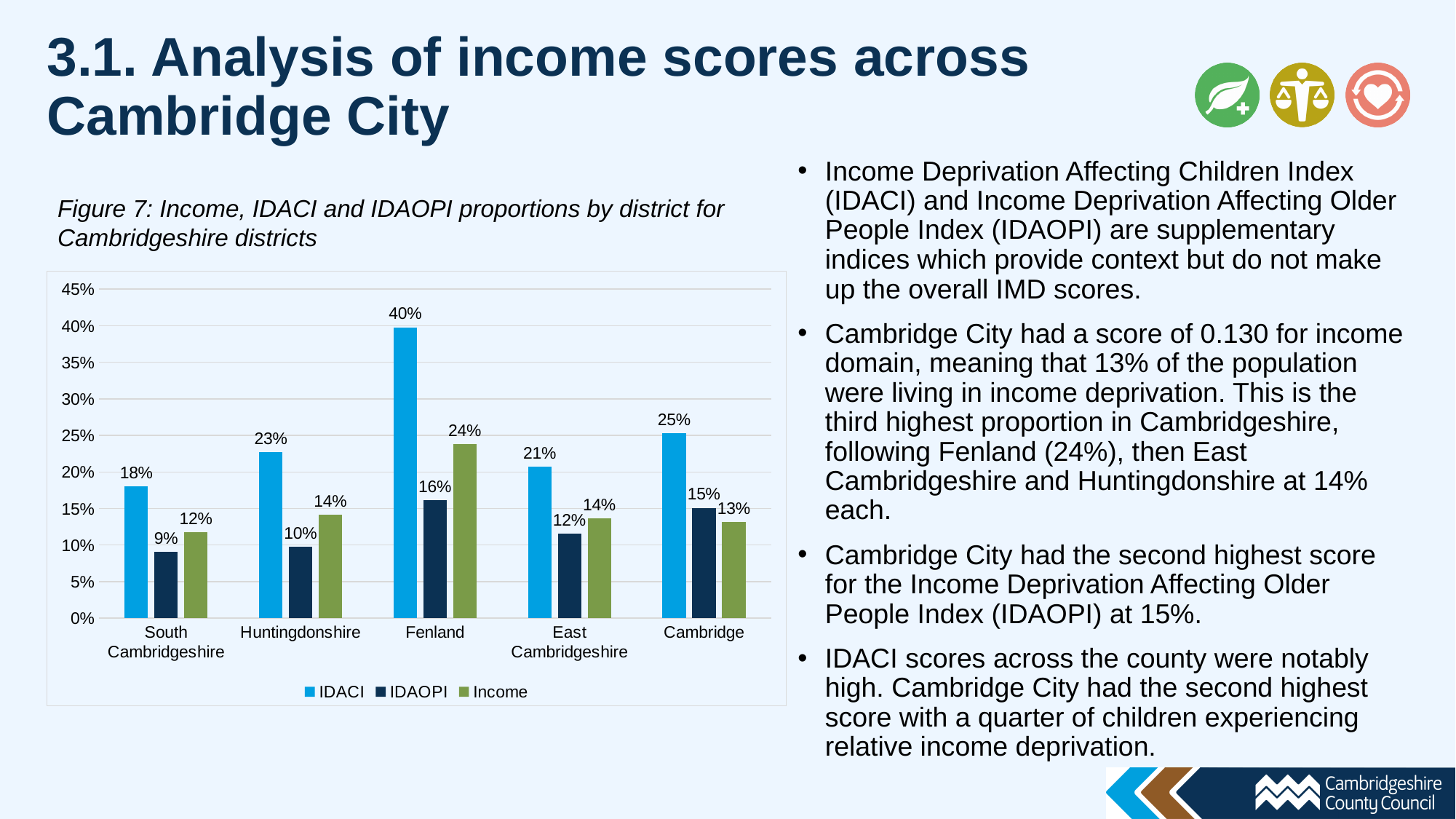
What is the figure caption above the chart? Figure 7: Income, IDACI and IDAOPI proportions by district for Cambridgeshire districts What is the difference between the IDACI and Income values for Fenland? 16% Is the IDACI value for East Cambridgeshire greater or less than 20%? greater How many series does the legend list? 3 What kind of chart is shown? bar chart Which is larger, the IDACI value for Cambridge or the IDACI value for Huntingdonshire? Cambridge How many districts are shown on the x axis? 5 Which district has the highest IDACI value? Fenland What is the IDAOPI value for South Cambridgeshire? 9% What is the Income value for Cambridge? 13% What is the IDACI value for Fenland? 40% Which district has the lowest IDAOPI value? South Cambridgeshire